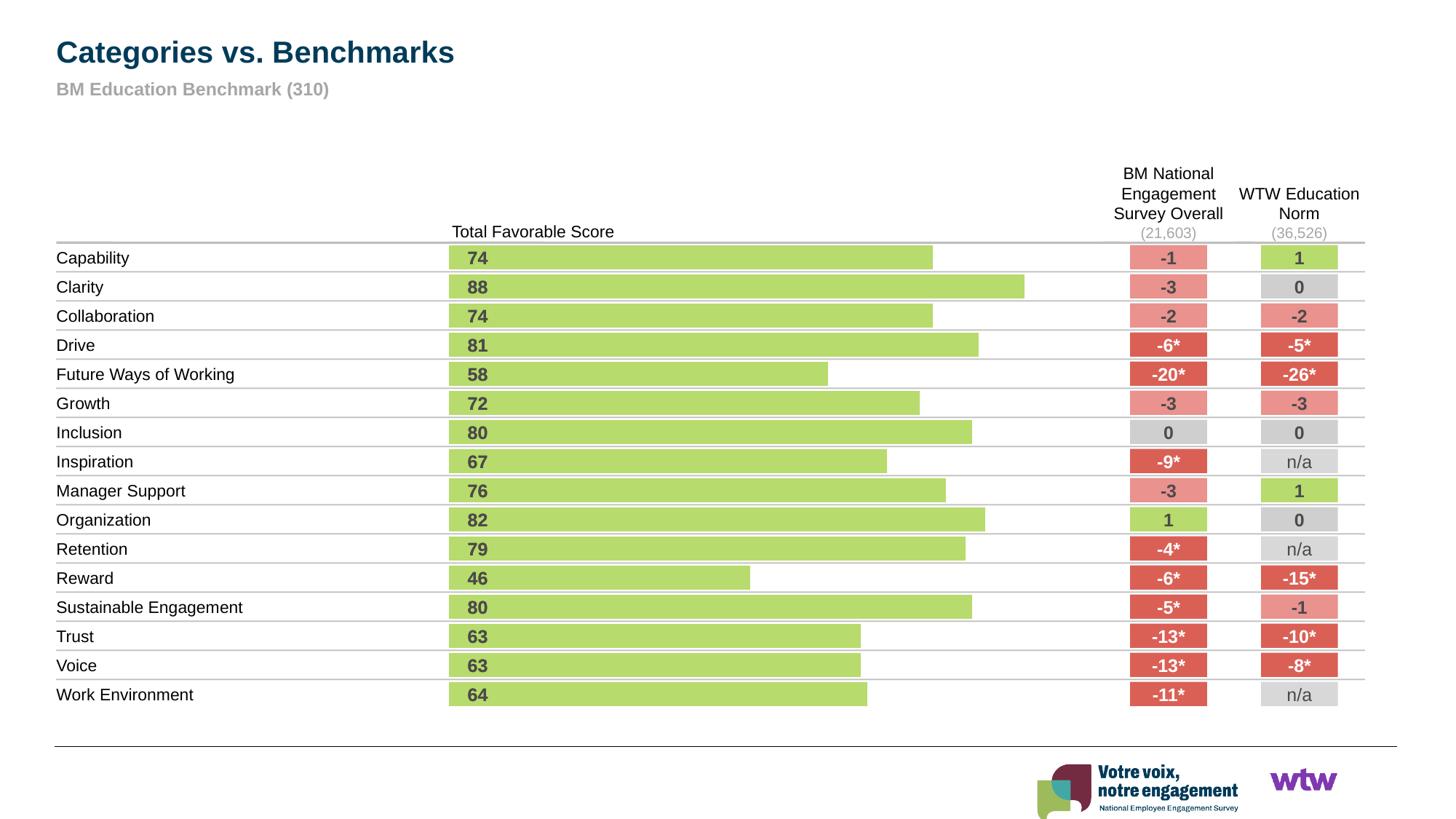
What is the difference between the Total Favorable Scores for Inclusion and Inspiration? 13 What is the difference versus the WTW Education Norm for Reward? -15* What is the title of the chart? Categories vs. Benchmarks Which has a higher Total Favorable Score, Drive or Organization? Organization What kind of chart is used to show the Total Favorable Score? Bar chart How many categories are shown in the chart? 16 Which category has the lowest Total Favorable Score? Reward Which category has the highest Total Favorable Score? Clarity What is the difference between the Total Favorable Scores for Clarity and Reward? 42 What is the Total Favorable Score for Future Ways of Working? 58 What is the difference versus the BM National Engagement Survey Overall for Future Ways of Working? -20* What is the Total Favorable Score for Clarity? 88